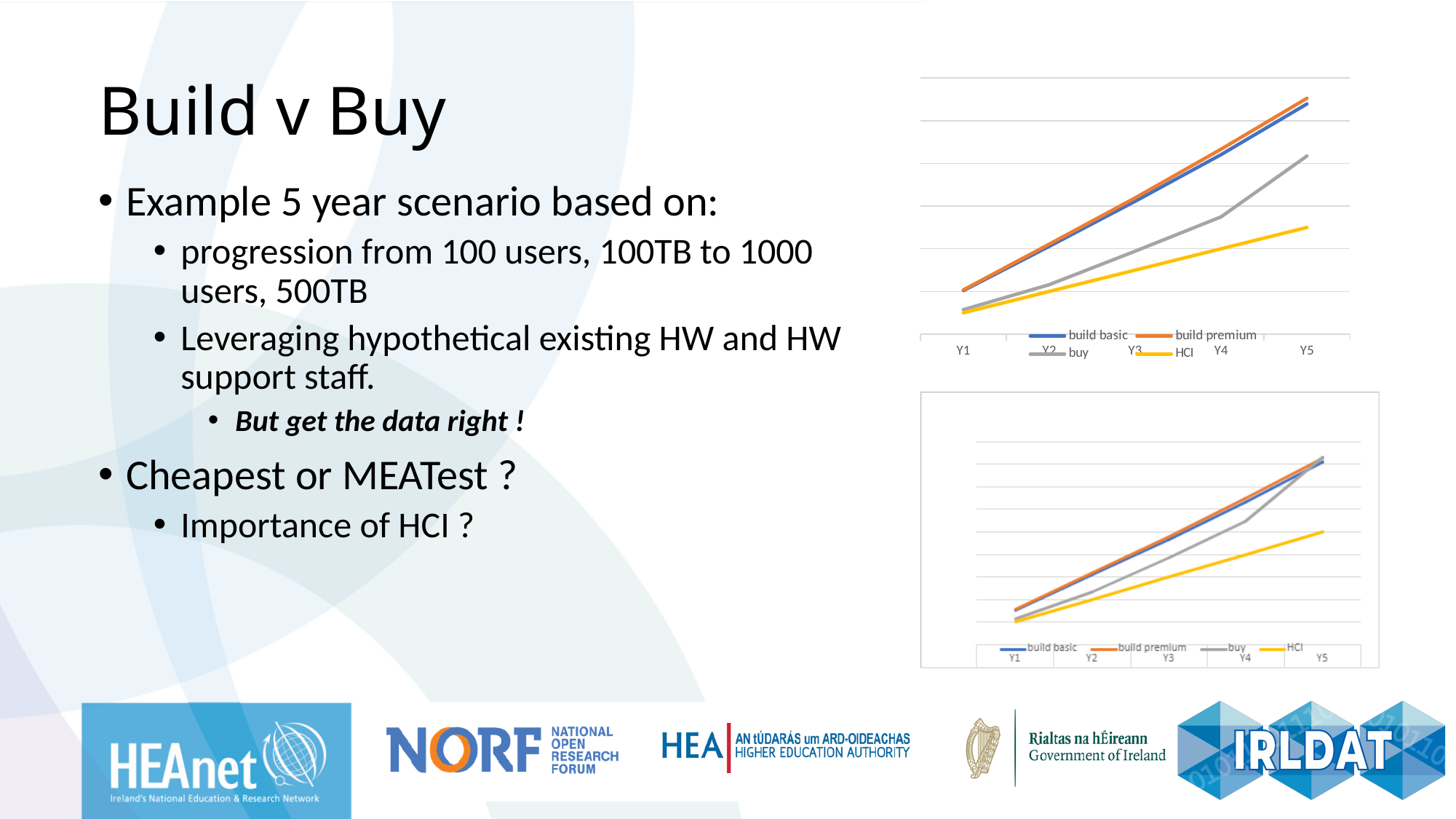
In the bottom chart, how many series does the legend list? 4 In the top chart, how many categories are shown on the x axis? 5 In the top chart, what are the four series named in the legend? build basic, build premium, buy, HCI In the bottom chart, which series has the lowest value at Y5? HCI What kind of chart is the bottom chart on the right of the slide? line chart In the top chart, how many series does the legend list? 4 What kind of chart is the top chart on the right of the slide? line chart In the top chart, does the build basic series rise or fall from Y1 to Y5? rise In the bottom chart, does the HCI series rise or fall from Y1 to Y5? rise In the bottom chart, how many categories are shown on the x axis? 5 In the top chart, which series has the lowest value at Y5? HCI In the top chart, which is higher at Y5: buy or HCI? buy